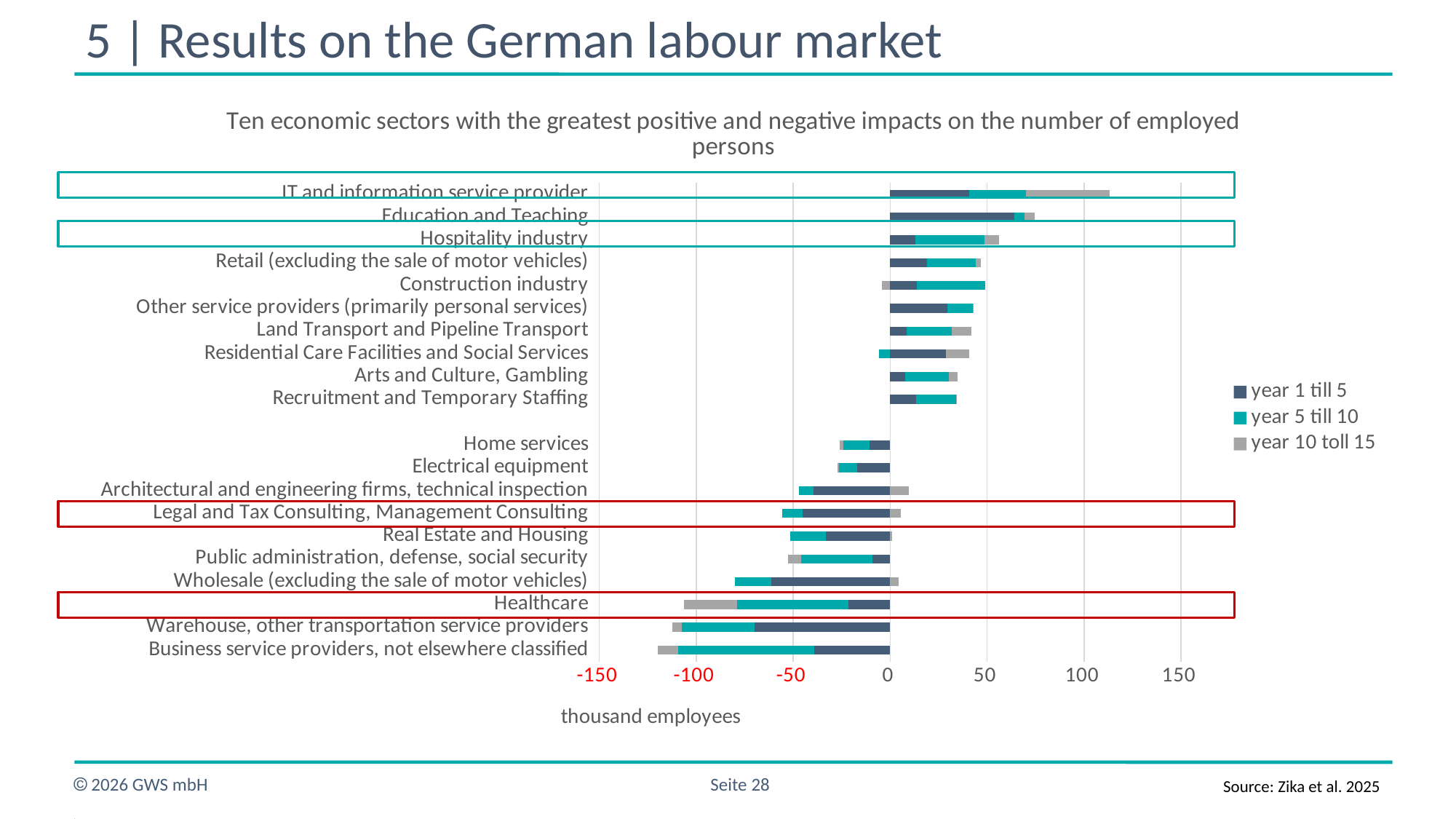
Is the total value for Home services greater or less than -50 thousand employees? greater Which legend entry is shown in the light grey colour? year 10 toll 15 What unit is shown on the x axis of the chart? thousand employees Is the total value for Healthcare greater or less than -100 thousand employees? less How many series does the legend list? 3 What kind of chart is shown on the slide? bar chart Is the total value for Retail (excluding the sale of motor vehicles) greater or less than 50 thousand employees? less Which sector has the largest positive total impact on the number of employed persons? IT and information service provider Which has the larger positive total, IT and information service provider or Education and Teaching? IT and information service provider How many economic sectors are plotted in the chart? 20